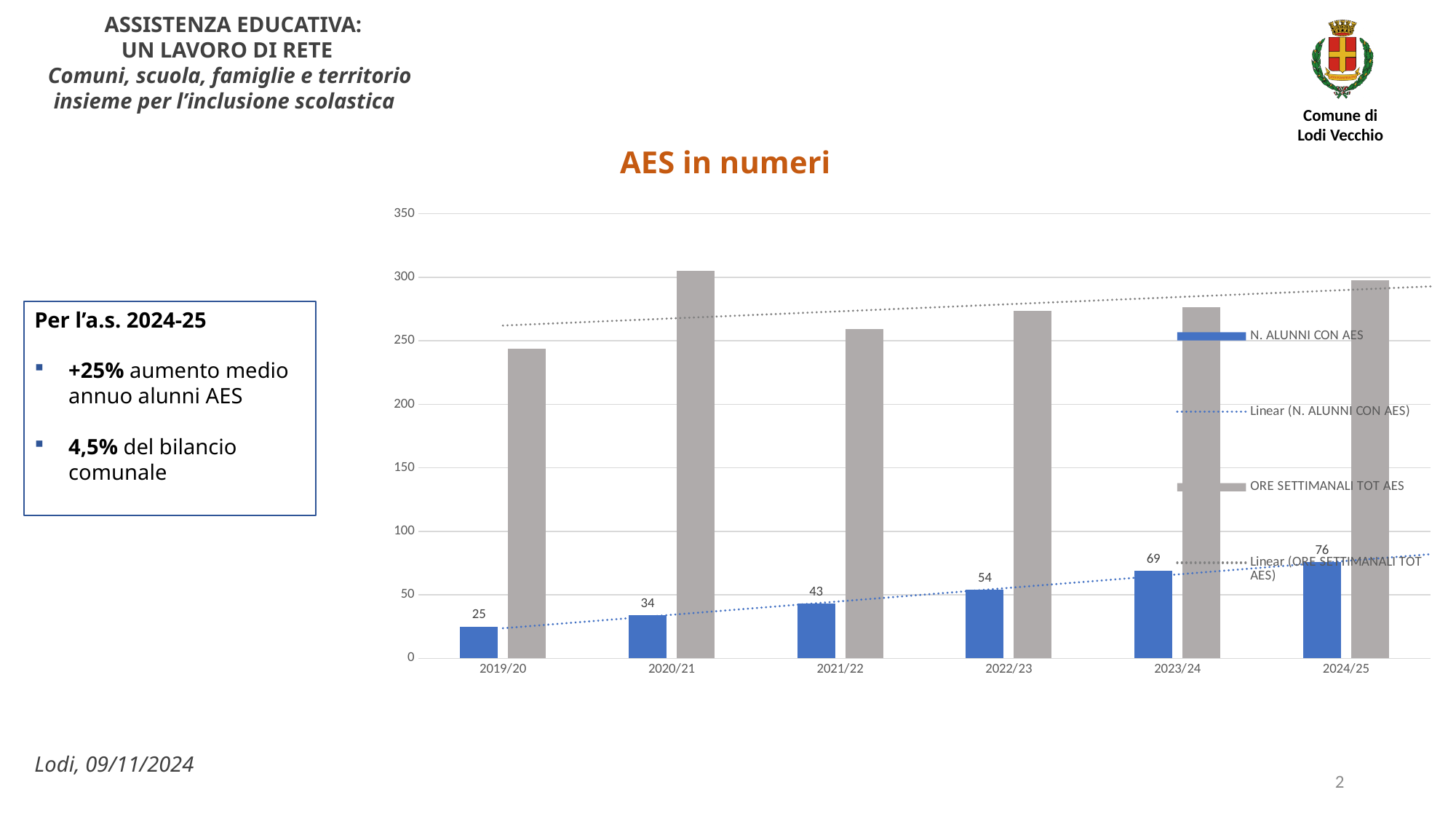
Which is larger, N. ALUNNI CON AES in 2023/24 or in 2021/22? 2023/24 How many school years are shown on the x axis of the chart? 6 What is the value of N. ALUNNI CON AES for 2019/20? 25 Is the value of ORE SETTIMANALI TOT AES for 2020/21 greater or less than 300? greater What is the difference between N. ALUNNI CON AES in 2024/25 and in 2019/20? 51 Is the value of ORE SETTIMANALI TOT AES for 2019/20 greater or less than 250? less What is the value of N. ALUNNI CON AES for 2024/25? 76 Which school year has the highest value for N. ALUNNI CON AES? 2024/25 What is the value of N. ALUNNI CON AES for 2022/23? 54 Does N. ALUNNI CON AES rise or fall from 2019/20 to 2024/25? rise Which school year has the lowest value for ORE SETTIMANALI TOT AES? 2019/20 How many entries does the chart legend list? 4